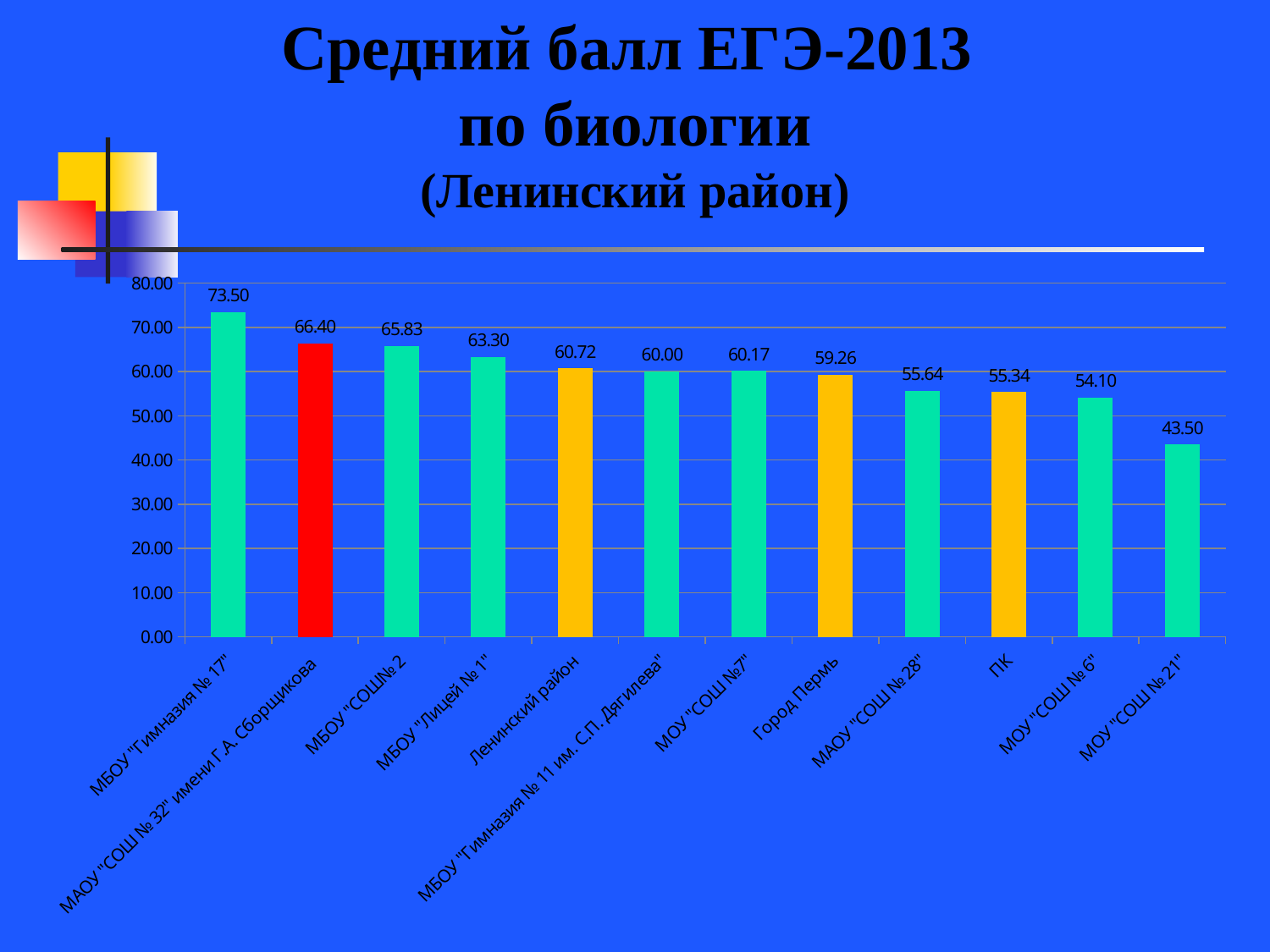
What is the value for Ленинский район? 60.72 What is the difference between the values for Ленинский район and Город Пермь? 1.46 What is the value for МБОУ "Гимназия № 17"? 73.50 Which category has the highest value? МБОУ "Гимназия № 17" What is the difference between the values for МБОУ "Гимназия № 17" and МОУ "СОШ № 21"? 30.00 What is the value for МОУ "СОШ № 21"? 43.50 What is the value for Город Пермь? 59.26 Which is larger, the value for МБОУ "Лицей № 1" or the value for МАОУ "СОШ № 28"? МБОУ "Лицей № 1" What kind of chart is shown on the slide? Bar chart Which bar is coloured red? МАОУ "СОШ № 32" имени Г.А. Сборщикова How many categories are shown on the x axis? 12 Which category has the lowest value? МОУ "СОШ № 21"